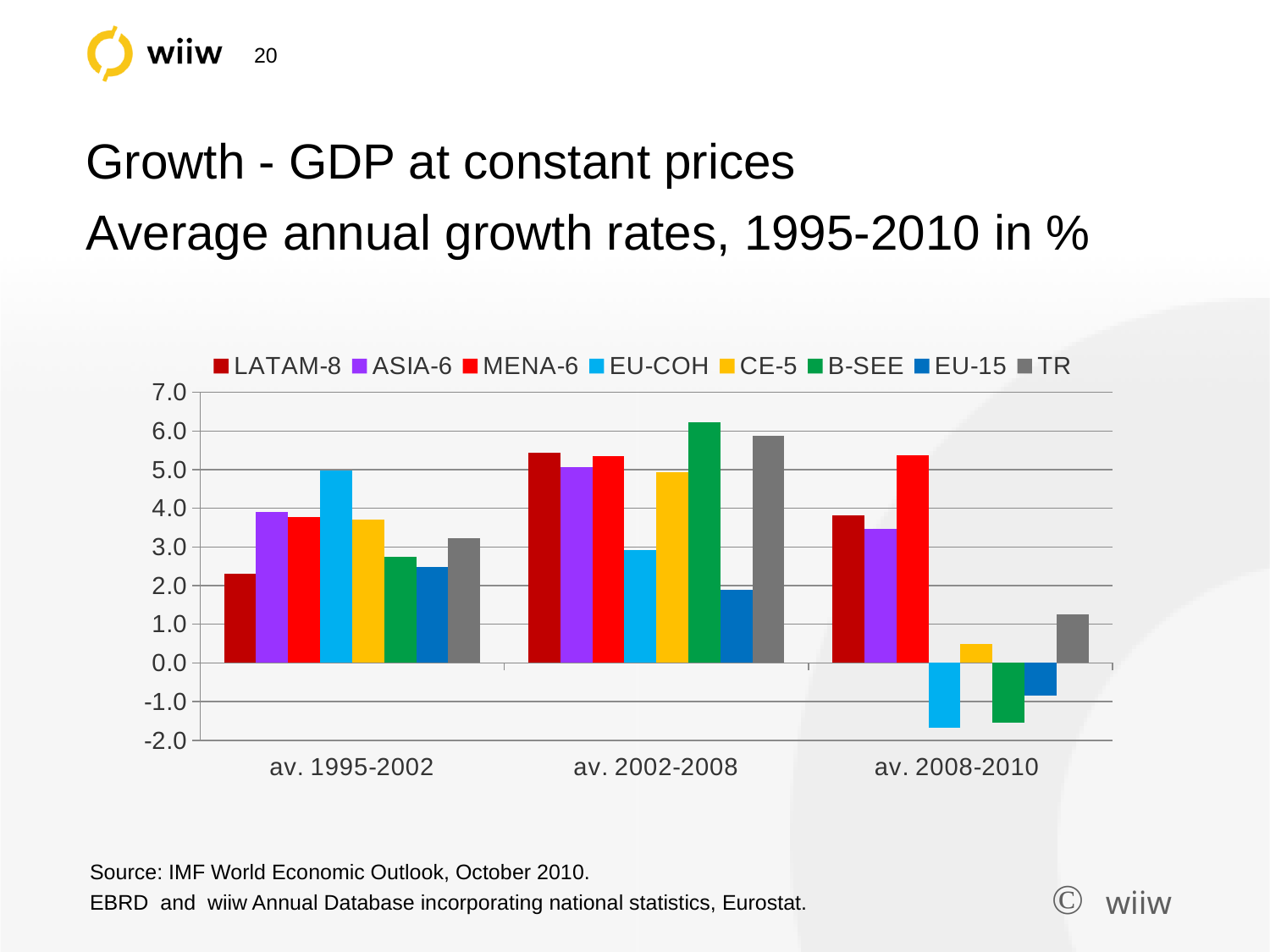
In av. 2002-2008, which is larger: LATAM-8 or EU-COH? LATAM-8 Which region has the highest average growth rate in av. 2008-2010? MENA-6 Is the value for EU-COH in av. 2008-2010 greater or less than -1.0? less Is the value for B-SEE in av. 2002-2008 greater or less than 6.0? greater How many period categories are shown on the x axis? 3 How many regions have a negative average growth rate in av. 2008-2010? 3 What kind of chart is shown on the slide? bar chart Does the value for EU-COH rise or fall across the three periods from av. 1995-2002 to av. 2008-2010? fall How many series does the legend list? 8 Which region has the highest average growth rate in av. 2002-2008? B-SEE Which region has the lowest average growth rate in av. 2002-2008? EU-15 Which region has the highest average growth rate in av. 1995-2002? EU-COH